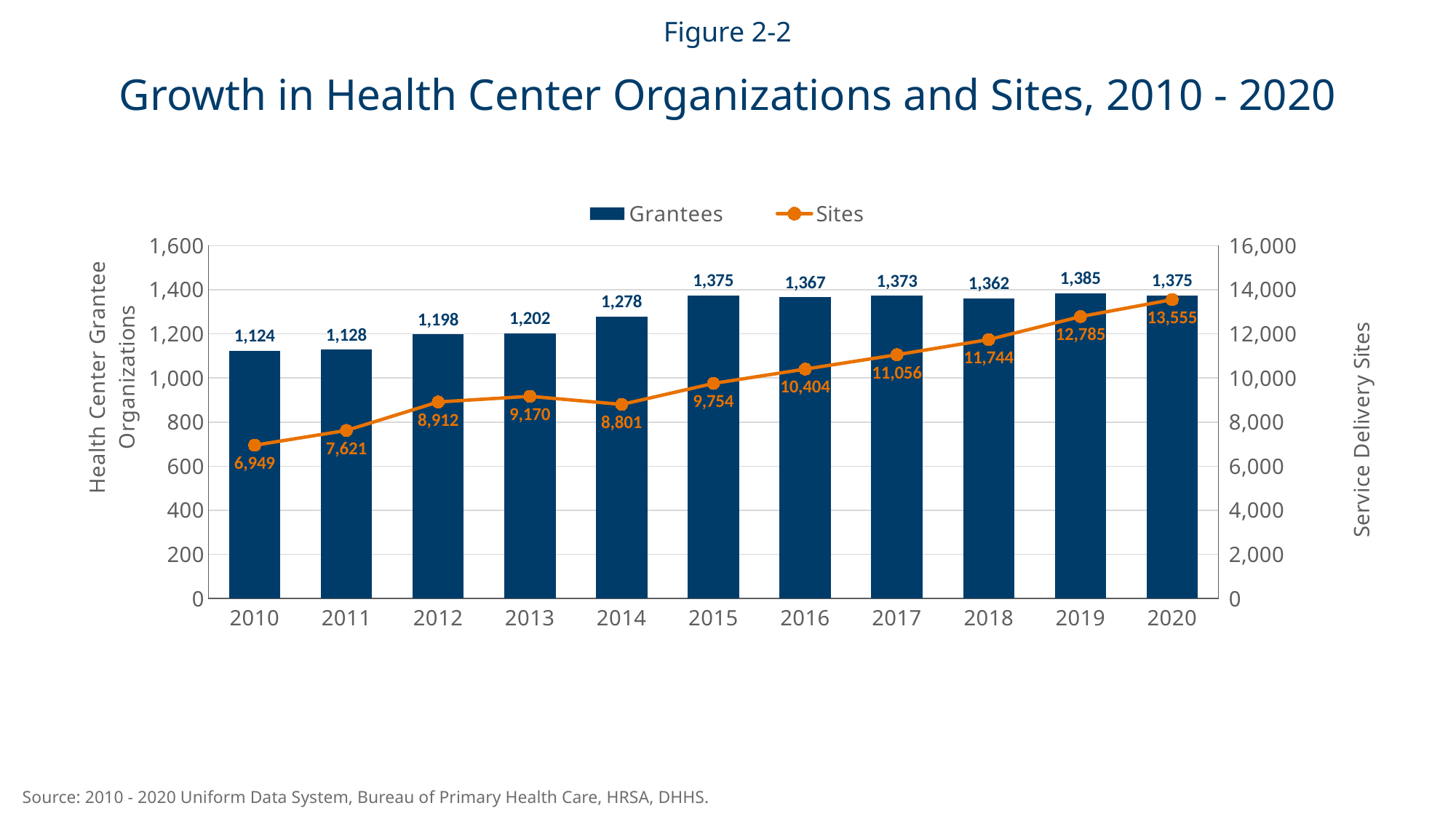
What kind of chart is this? Combined bar and line chart What is the title of the chart? Growth in Health Center Organizations and Sites, 2010 - 2020 Which year has the lowest number of Sites? 2010 What is the difference in Sites between 2020 and 2019? 770 What is the number of Grantees in 2014? 1,278 How many series does the legend list? 2 Is the number of Grantees in 2012 greater or less than 1,400? less What is the difference in Grantees between 2015 and 2014? 97 What is the number of Sites in 2017? 11,056 Which year has more Sites, 2013 or 2014? 2013 How many years are shown on the x axis? 11 Which year has the highest number of Grantees? 2019